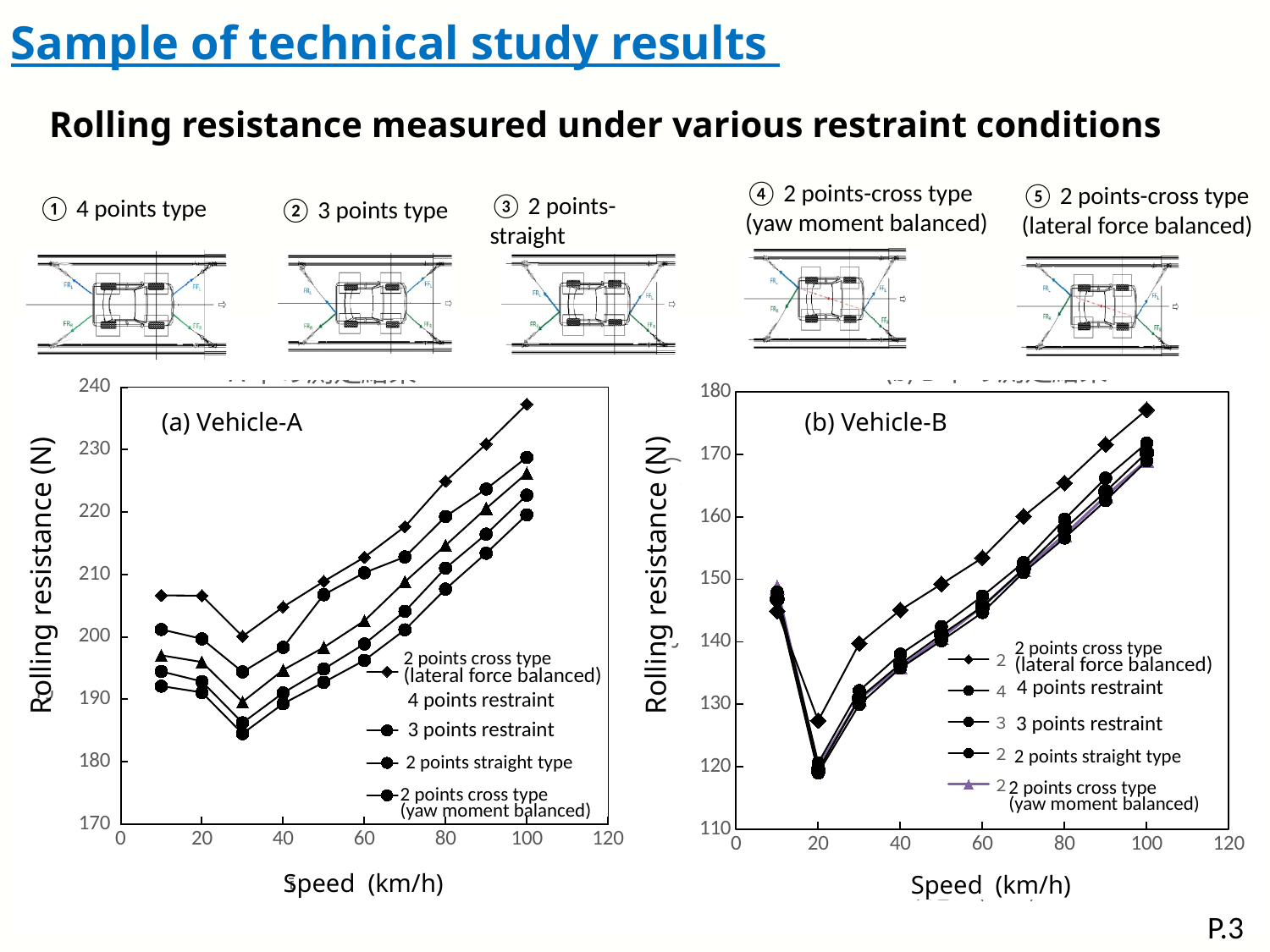
In the (b) Vehicle-B chart, is the value for the 4 points restraint series at 100 km/h greater or less than 160? greater In the (a) Vehicle-A chart, is the value for the 4 points restraint series at 100 km/h greater or less than 220? greater In the (a) Vehicle-A chart, at which speed does the 2 points cross type (lateral force balanced) series reach its lowest rolling resistance? 30 km/h In the (b) Vehicle-B chart, at 20 km/h, which is larger: the 2 points cross type (lateral force balanced) series or the 4 points restraint series? 2 points cross type (lateral force balanced) In the (a) Vehicle-A chart, is the value for the 2 points cross type (lateral force balanced) series at 100 km/h greater or less than 230? greater What is the x-axis label of the (b) Vehicle-B chart? Speed (km/h) How many series does the legend of the (b) Vehicle-B chart list? 5 In the (b) Vehicle-B chart, between 30 km/h and 100 km/h, does the rolling resistance of the 2 points cross type (lateral force balanced) series rise or fall? rise In the (a) Vehicle-A chart, which series has the highest rolling resistance at 100 km/h? 2 points cross type (lateral force balanced) How many speed points are plotted for each series in the (a) Vehicle-A chart? 10 What kind of chart is the (a) Vehicle-A chart? line chart